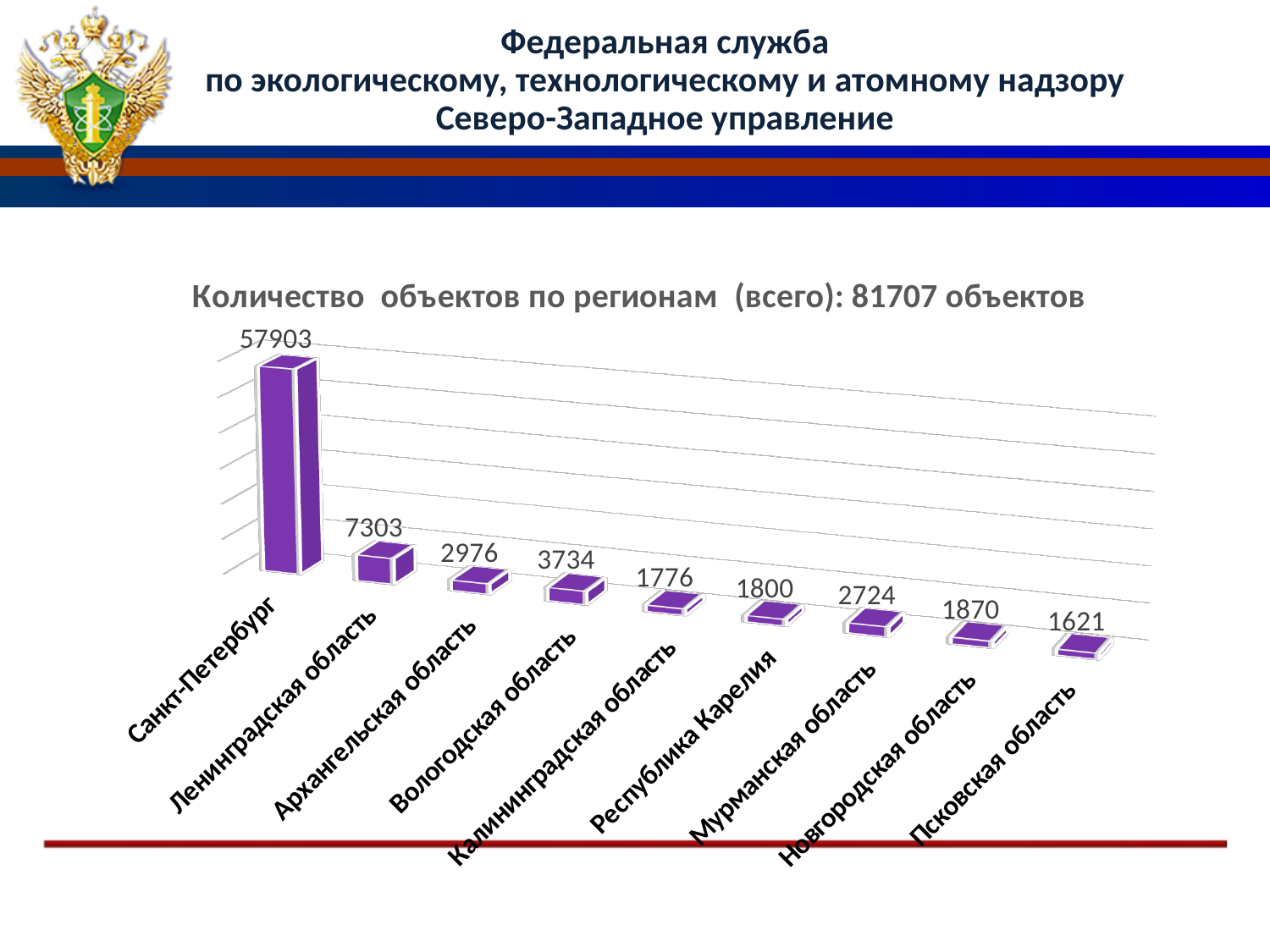
What is the value for Мурманская область? 2724 What is the value for Санкт-Петербург? 57903 Which region has the highest value? Санкт-Петербург What is the difference between the values for Санкт-Петербург and Ленинградская область? 50600 What is the value for Республика Карелия? 1800 What is the value for Ленинградская область? 7303 What kind of chart is shown on the slide? Bar chart How many regions are shown in the chart? 9 What is the difference between the values for Вологодская область and Архангельская область? 758 Which region has the lowest value? Псковская область Which is larger, the value for Новгородская область or the value for Калининградская область? Новгородская область What total number of objects is stated in the chart title? 81707